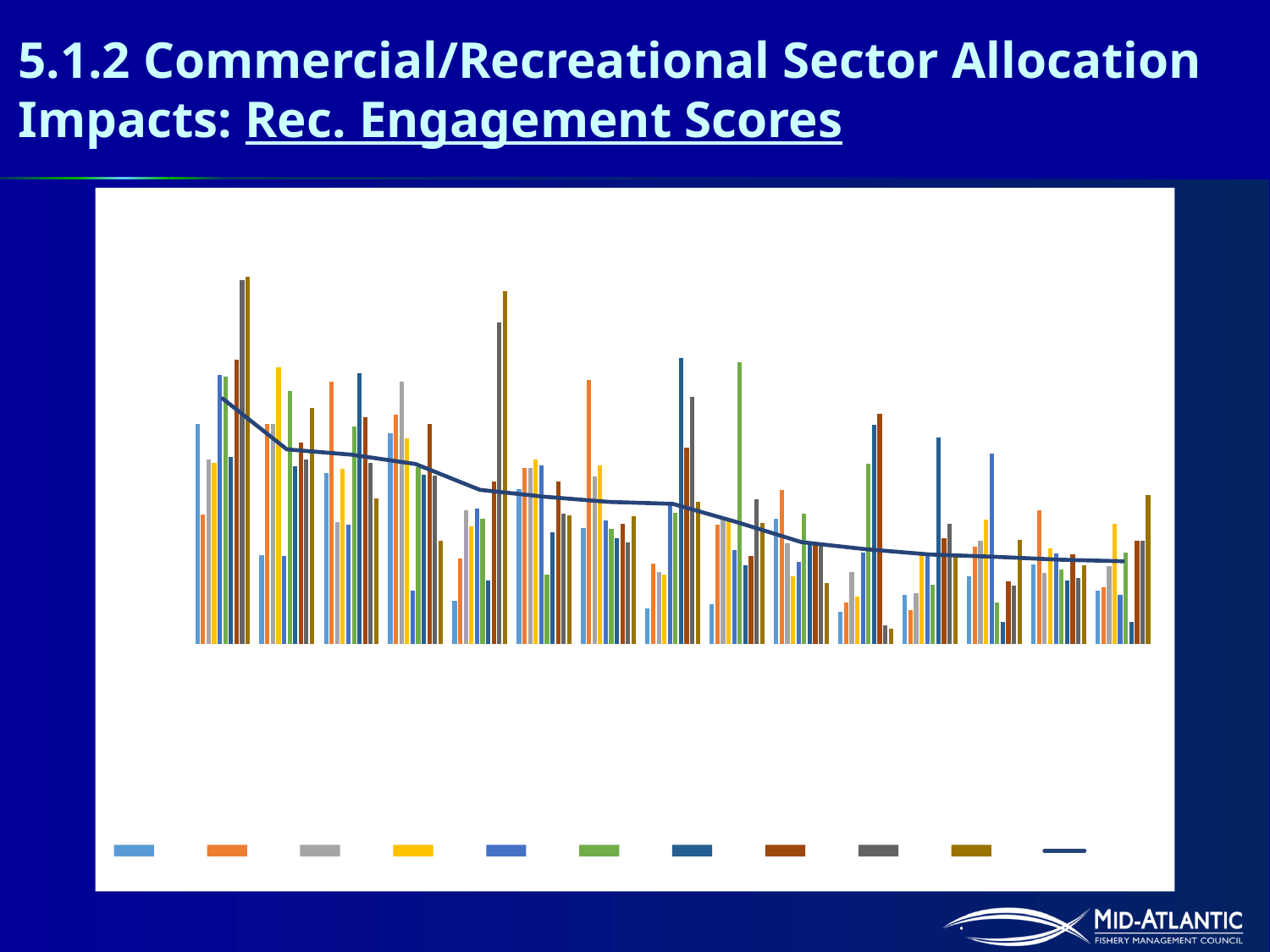
Does the line plotted across the chart rise or fall from left to right? Fall What kind of chart is shown on the slide? A bar chart with a line overlay How many entries does the chart's legend show? 11 How many of the legend entries are shown as a line rather than a colored bar swatch? 1 According to the slide title, what scores does the chart show? Rec. Engagement Scores